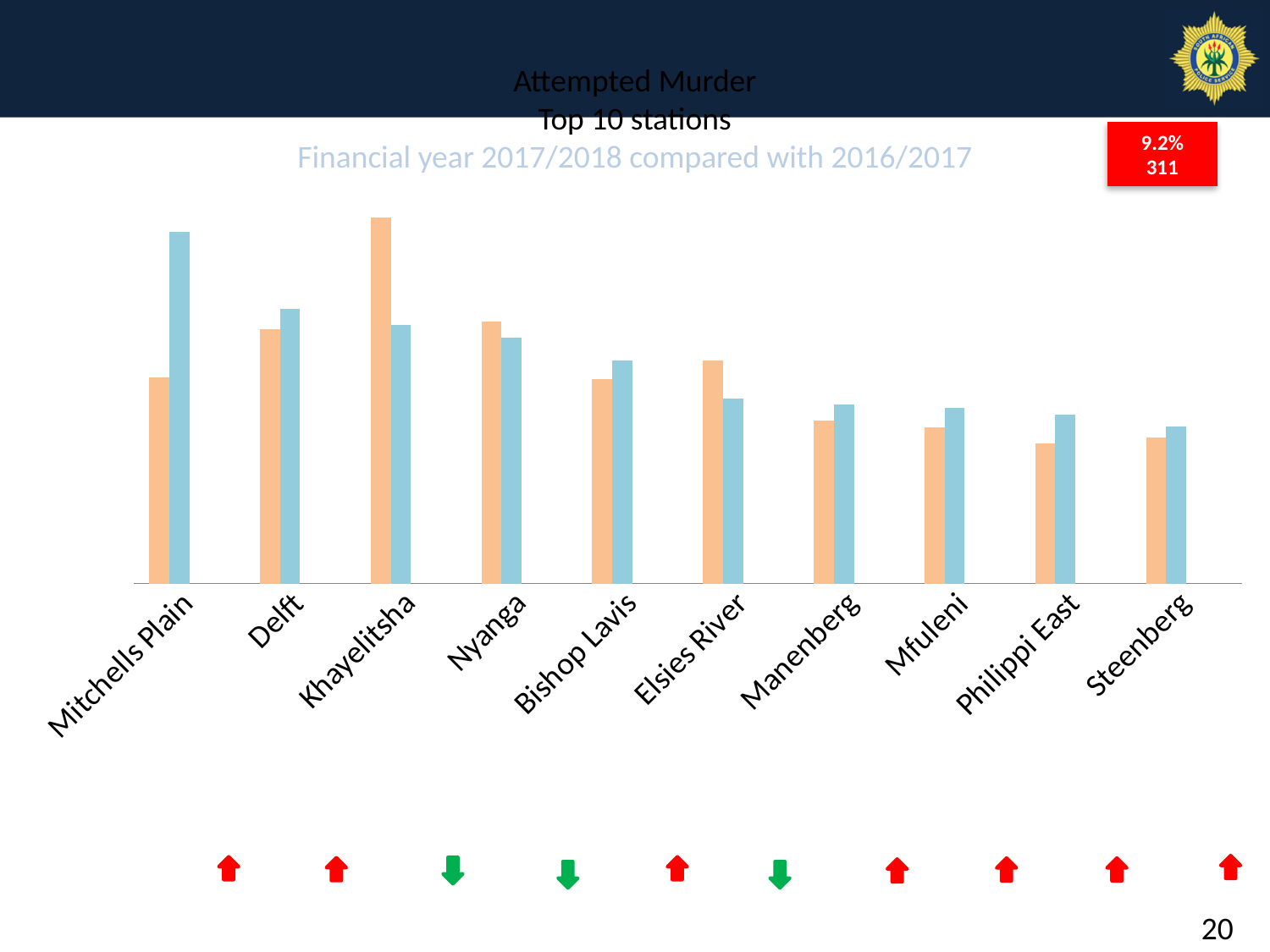
How many bars are plotted for each station in the chart? 2 What is the main title of the chart? Attempted Murder Top 10 stations Which two financial years does the chart subtitle say are compared? 2017/2018 and 2016/2017 For Mitchells Plain, which bar is taller, the orange bar or the blue bar? the blue bar For Elsies River, which bar is taller, the orange bar or the blue bar? the orange bar How many stations are shown on the x axis of the chart? 10 Do the blue bars generally rise or fall from left to right across the stations? fall For Khayelitsha, which bar is taller, the orange bar or the blue bar? the orange bar What kind of chart is shown on the slide? bar chart Which station has the tallest blue bar in the chart? Mitchells Plain Which station has the tallest bar in the chart? Khayelitsha